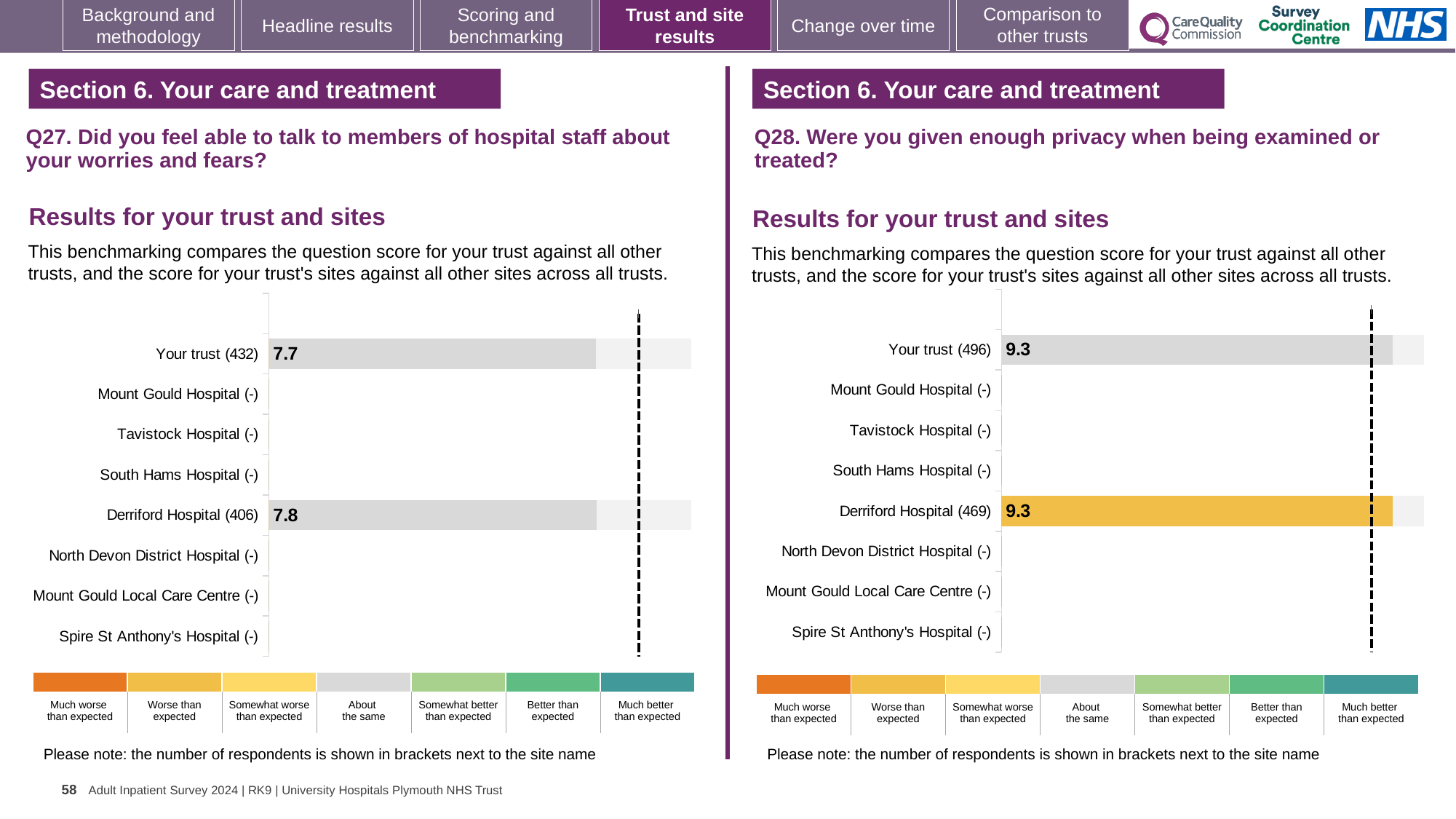
How many benchmark categories does the colour legend below the Q27 chart on the left list? 7 In the Q27 chart on the left, which has the higher score, Your trust or Derriford Hospital? Derriford Hospital In the Q28 chart on the right, how many respondents are shown in brackets for Your trust? 496 In the Q27 chart on the left, what is the score for Your trust? 7.7 What kind of chart is used for the Q27 results on the left? Bar chart In the Q27 chart on the left, what is the difference between the Derriford Hospital score and the Your trust score? 0.1 In the Q28 chart on the right, what is the score for Your trust? 9.3 In the Q28 chart on the right, what is the score for Derriford Hospital? 9.3 In the Q27 chart on the left, what is the score for Derriford Hospital? 7.8 In the Q27 chart on the left, how many respondents are shown in brackets for Derriford Hospital? 406 How many site/trust categories are listed on the y axis of the Q28 chart on the right? 8 In the Q28 chart on the right, which benchmark category does the colour of the Derriford Hospital bar correspond to in the legend? Worse than expected